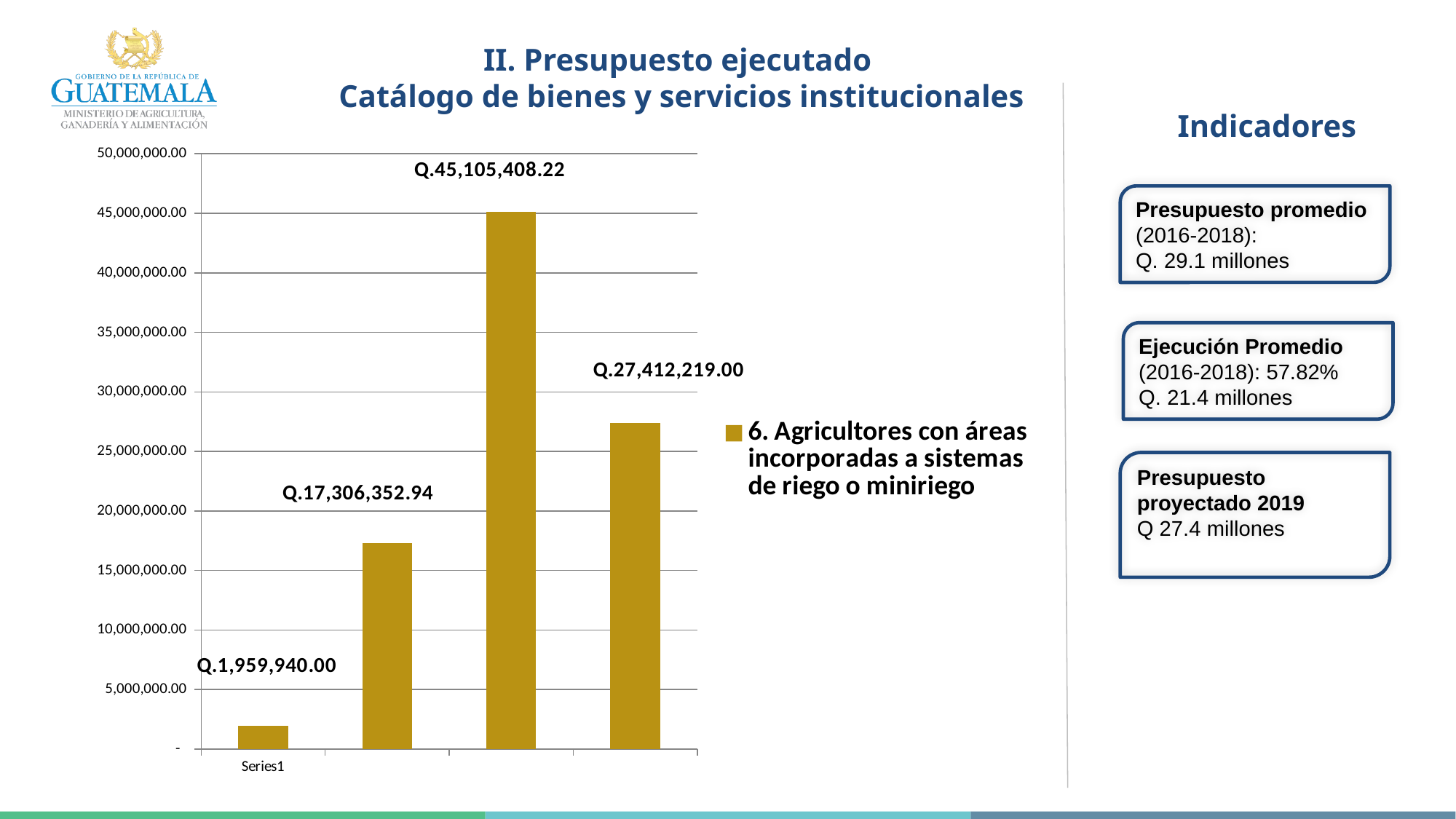
Which is larger, the second bar or the fourth bar? The fourth bar What is the value shown on the first (leftmost) bar, labelled Series1? Q.1,959,940.00 How many series does the chart legend list? 1 What is the value shown on the second bar from the left? Q.17,306,352.94 How many bars are plotted in the chart? 4 What is the difference between the third bar and the fourth bar? Q.17,693,189.22 What is the value shown on the third bar from the left? Q.45,105,408.22 What kind of chart is shown on the slide? Bar chart What is the value shown on the fourth (rightmost) bar? Q.27,412,219.00 What series name does the legend show for the bars? 6. Agricultores con áreas incorporadas a sistemas de riego o miniriego Which bar has the highest value? The third bar (Q.45,105,408.22) Which bar has the lowest value? The first bar, Series1 (Q.1,959,940.00)